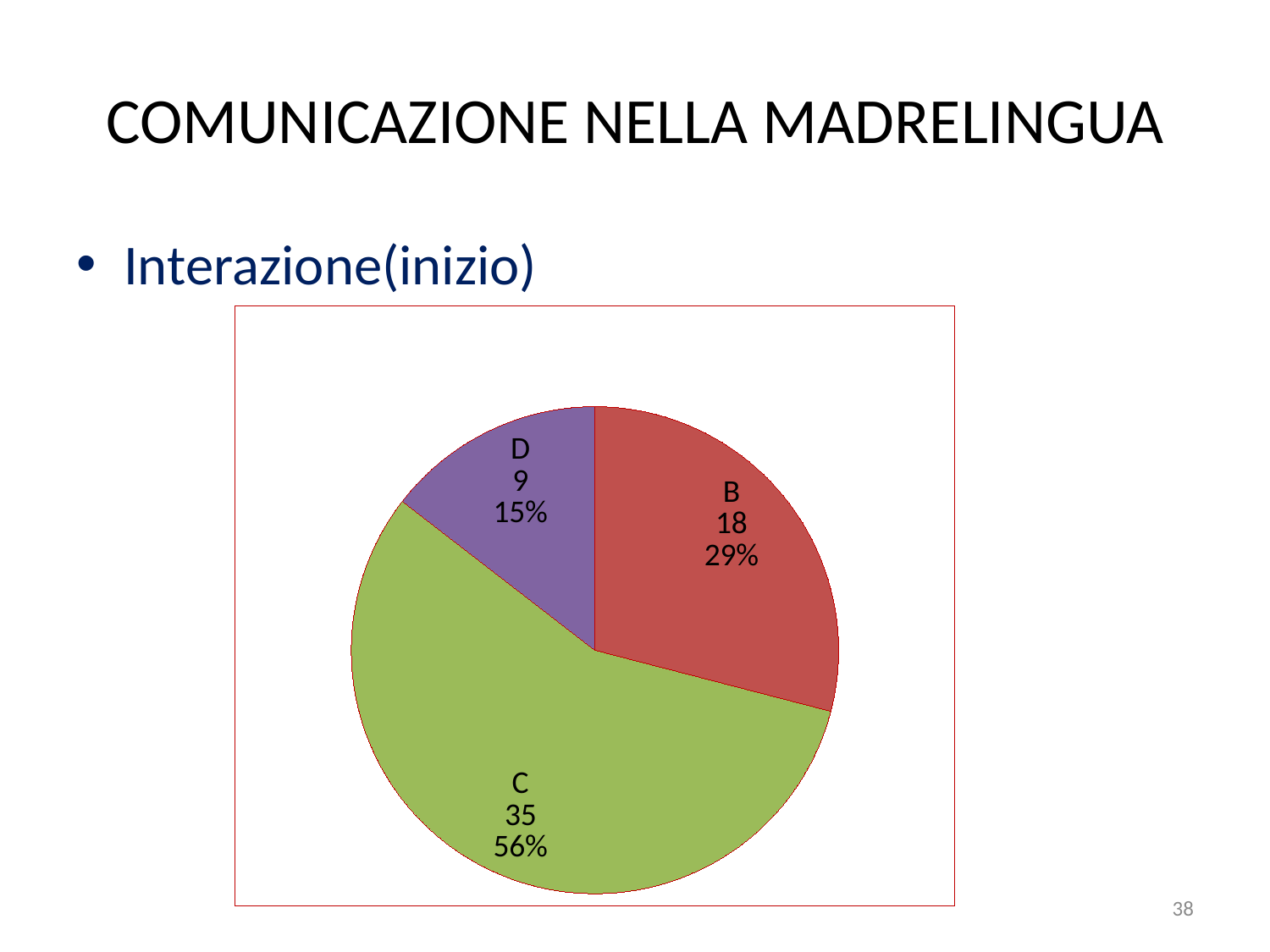
What is the value for category D? 9 What percentage share of the pie does category D have? 15% What is the value for category C? 35 What percentage share of the pie does category B have? 29% Which is larger, the value for B or the value for D? B Which category has the largest slice? C Which category has the smallest slice? D What colour is the slice for category C? green What kind of chart is shown on the slide? pie chart What is the value for category B? 18 How many slices does the pie chart have? 3 What is the difference between the values for C and B? 17